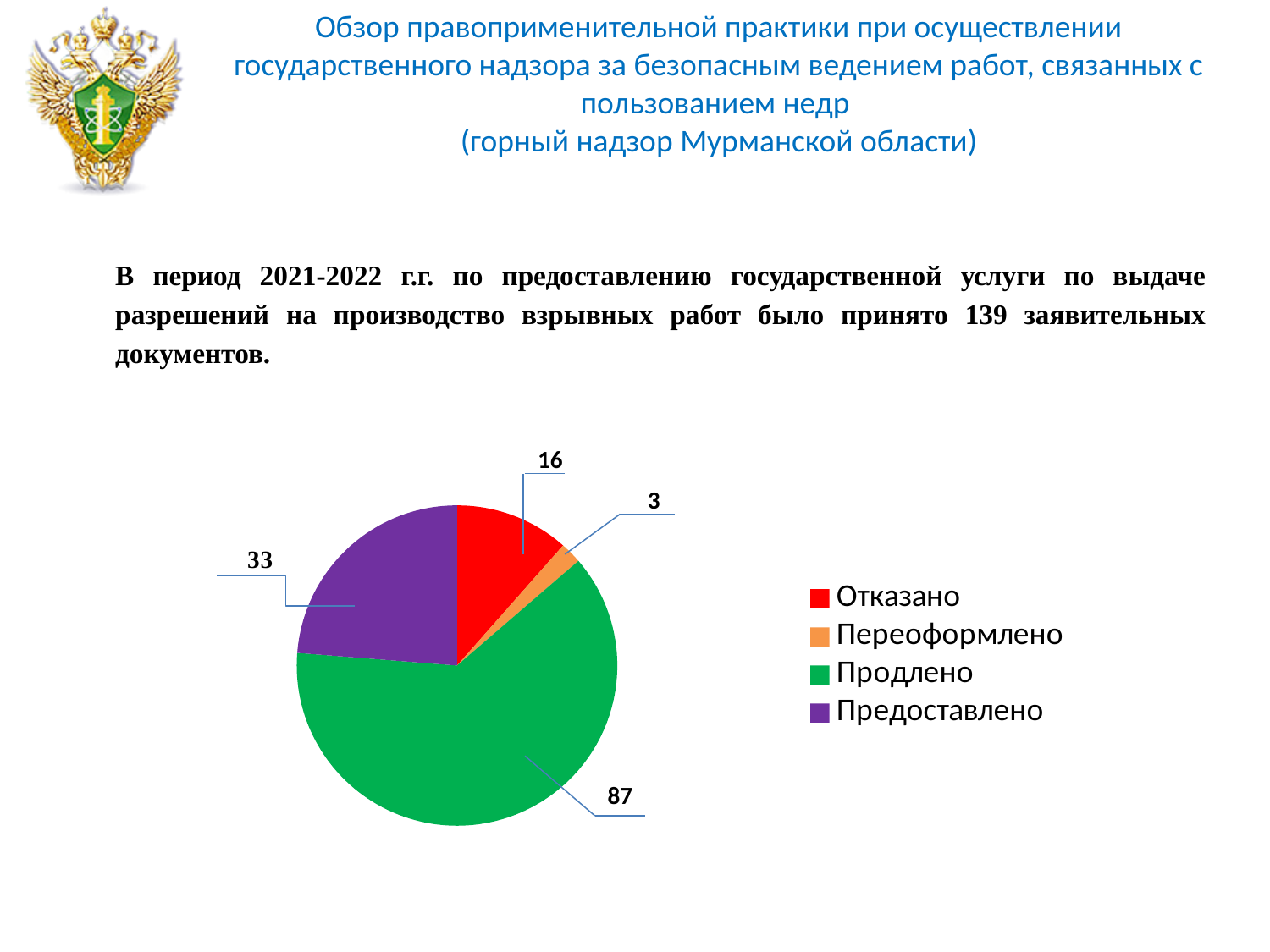
What is the total of all slices in the pie chart? 139 Which is larger, the value for Отказано or the value for Предоставлено? Предоставлено Which category has the largest slice in the pie chart? Продлено What is the value for Переоформлено in the pie chart? 3 How many categories does the pie chart have? 4 Which category has the smallest slice in the pie chart? Переоформлено What is the value for Продлено in the pie chart? 87 What is the value for Отказано in the pie chart? 16 What colour is the Продлено slice in the pie chart? green What type of chart is shown on the slide? pie chart What is the difference between the values for Продлено and Предоставлено? 54 What is the value for Предоставлено in the pie chart? 33